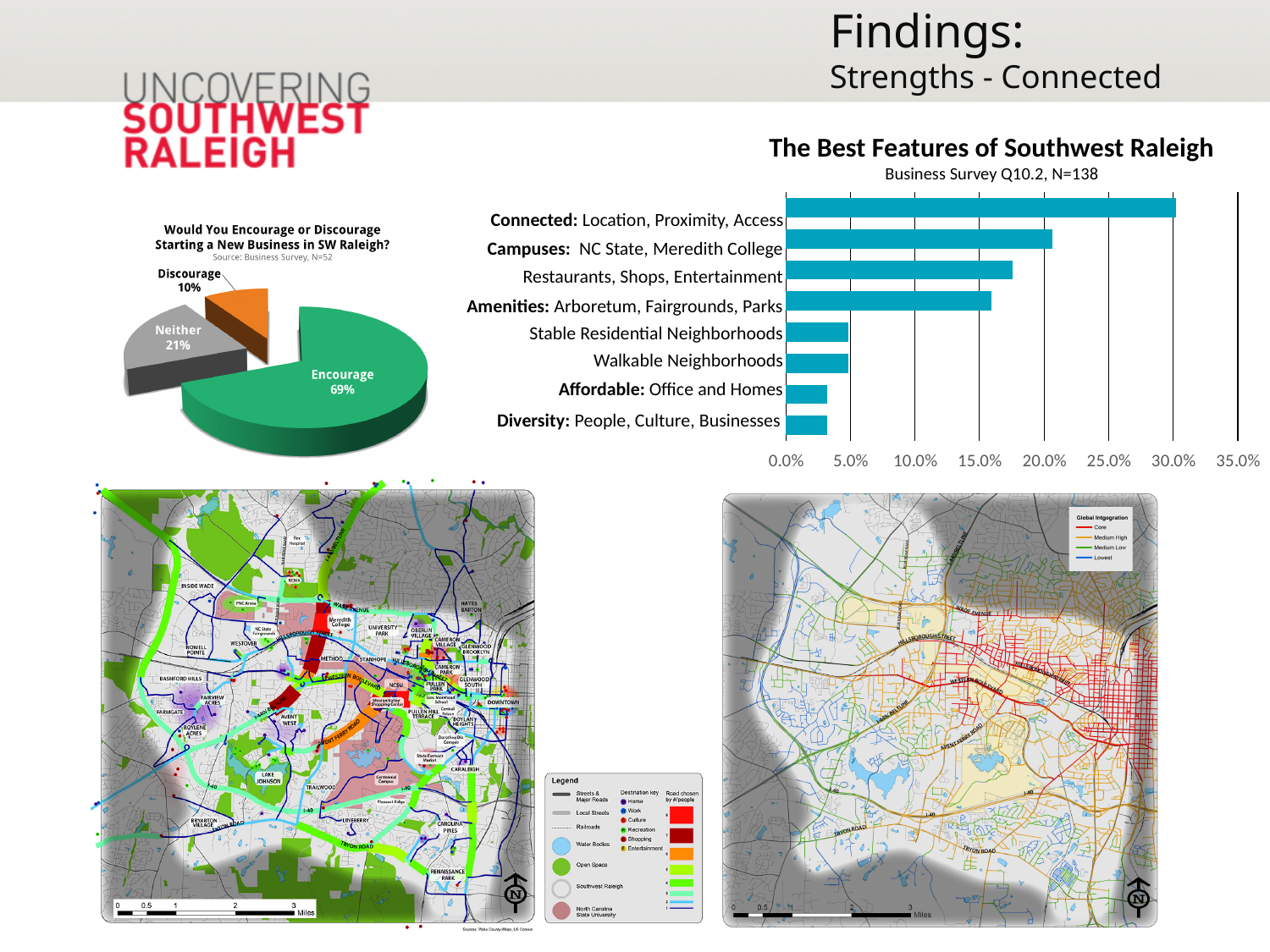
What kind of chart is 'The Best Features of Southwest Raleigh'? Bar chart In the pie chart 'Would You Encourage or Discourage Starting a New Business in SW Raleigh?', what share of respondents said Discourage? 10% What kind of chart is 'Would You Encourage or Discourage Starting a New Business in SW Raleigh?'? Pie chart In the pie chart 'Would You Encourage or Discourage Starting a New Business in SW Raleigh?', what share of respondents said Encourage? 69% In the chart 'The Best Features of Southwest Raleigh', is the value for 'Connected: Location, Proximity, Access' greater or less than 25.0%? greater In the pie chart 'Would You Encourage or Discourage Starting a New Business in SW Raleigh?', how many percentage points larger is Encourage than Neither? 48 percentage points In the chart 'The Best Features of Southwest Raleigh', which feature has the longest bar? Connected: Location, Proximity, Access How many slices does the pie chart 'Would You Encourage or Discourage Starting a New Business in SW Raleigh?' have? 3 In the chart 'The Best Features of Southwest Raleigh', which has the larger value: 'Campuses: NC State, Meredith College' or 'Restaurants, Shops, Entertainment'? Campuses: NC State, Meredith College In the chart 'The Best Features of Southwest Raleigh', is the value for 'Amenities: Arboretum, Fairgrounds, Parks' greater or less than 20.0%? less How many features are listed in the chart 'The Best Features of Southwest Raleigh'? 8 In the pie chart 'Would You Encourage or Discourage Starting a New Business in SW Raleigh?', which response has the smallest slice? Discourage